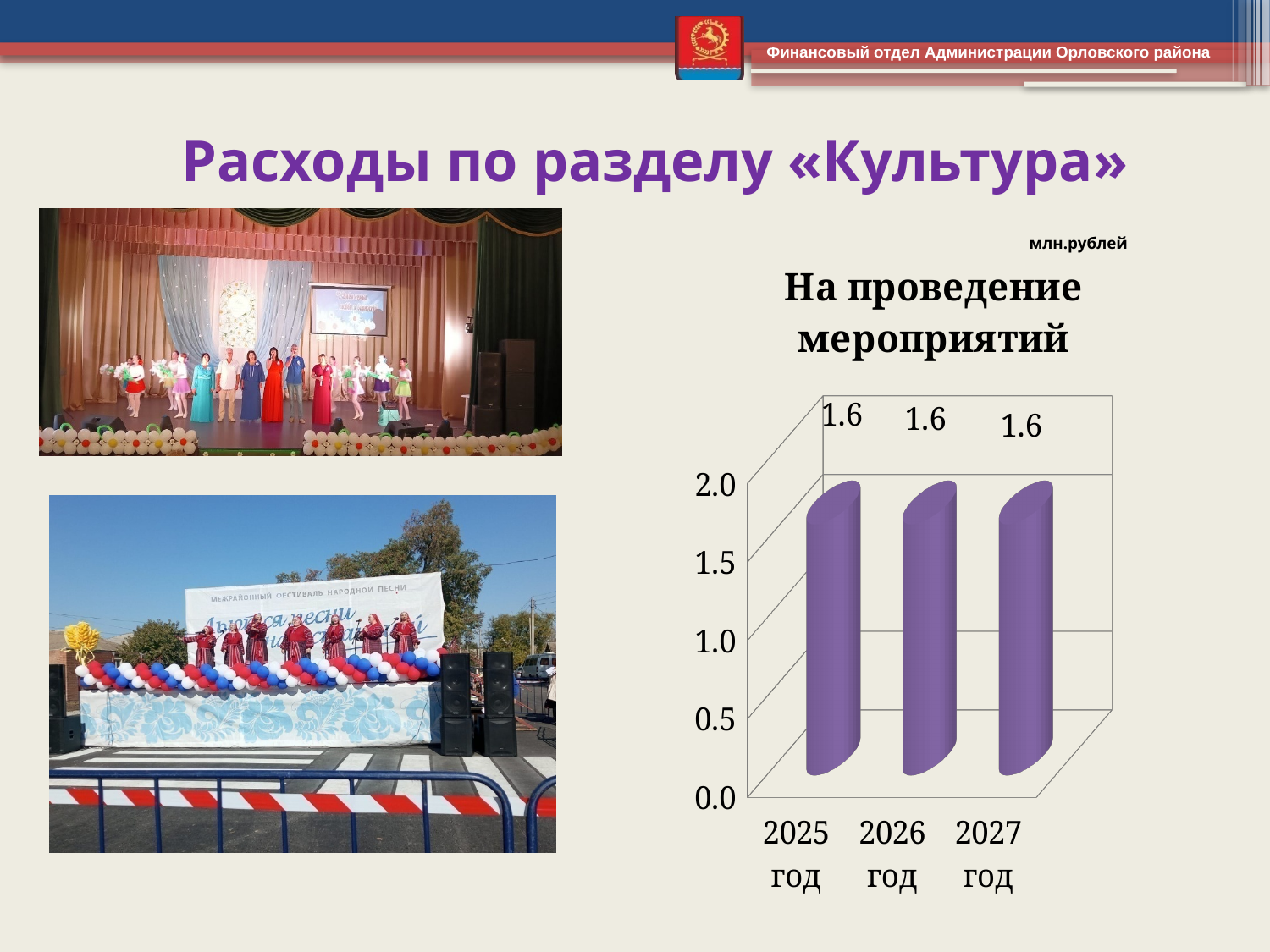
What is the difference between the values for 2025 год and 2027 год? 0.0 Is the value for 2025 год greater or less than 2.0? less Do the values rise, fall or stay the same from 2025 год to 2027 год? stay the same What kind of chart is shown on the slide? bar chart What is the value for 2026 год in the chart 'На проведение мероприятий'? 1.6 What is the title of the chart? На проведение мероприятий What unit is indicated above the chart? млн.рублей What is the highest value shown on the vertical axis of the chart? 2.0 What is the value for 2025 год in the chart 'На проведение мероприятий'? 1.6 How many categories are shown on the x axis of the chart? 3 What is the value for 2027 год in the chart 'На проведение мероприятий'? 1.6 Is the value for 2026 год greater or less than 1.0? greater